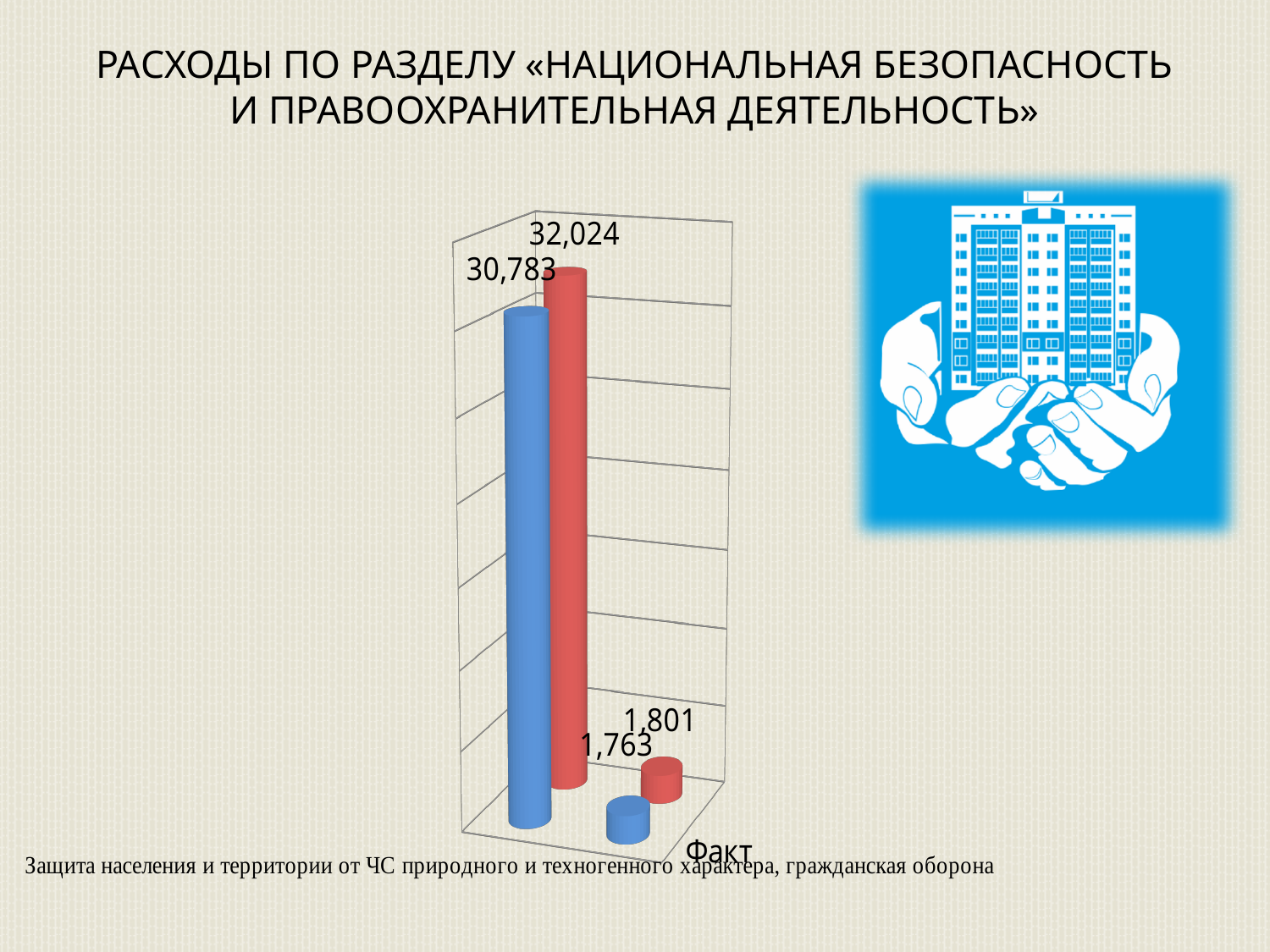
In the taller pair of bars, which is larger: the blue bar or the red bar? the red bar (32,024) What is the highest value labelled on the chart? 32,024 What value is labelled on the blue bar in the taller pair of bars? 30,783 What is the difference between the red bar (32,024) and the blue bar (30,783) in the taller pair? 1,241 What is the lowest value labelled on the chart? 1,763 What category label is printed at the bottom right of the chart's base? Факт What value is labelled on the red bar in the taller pair of bars? 32,024 What kind of chart is shown on the slide? bar chart How many bars are plotted on the chart? 4 What value is labelled on the red bar in the shorter pair of bars? 1,801 What value is labelled on the blue bar in the shorter pair of bars? 1,763 What is the difference between the red bar (1,801) and the blue bar (1,763) in the shorter pair? 38